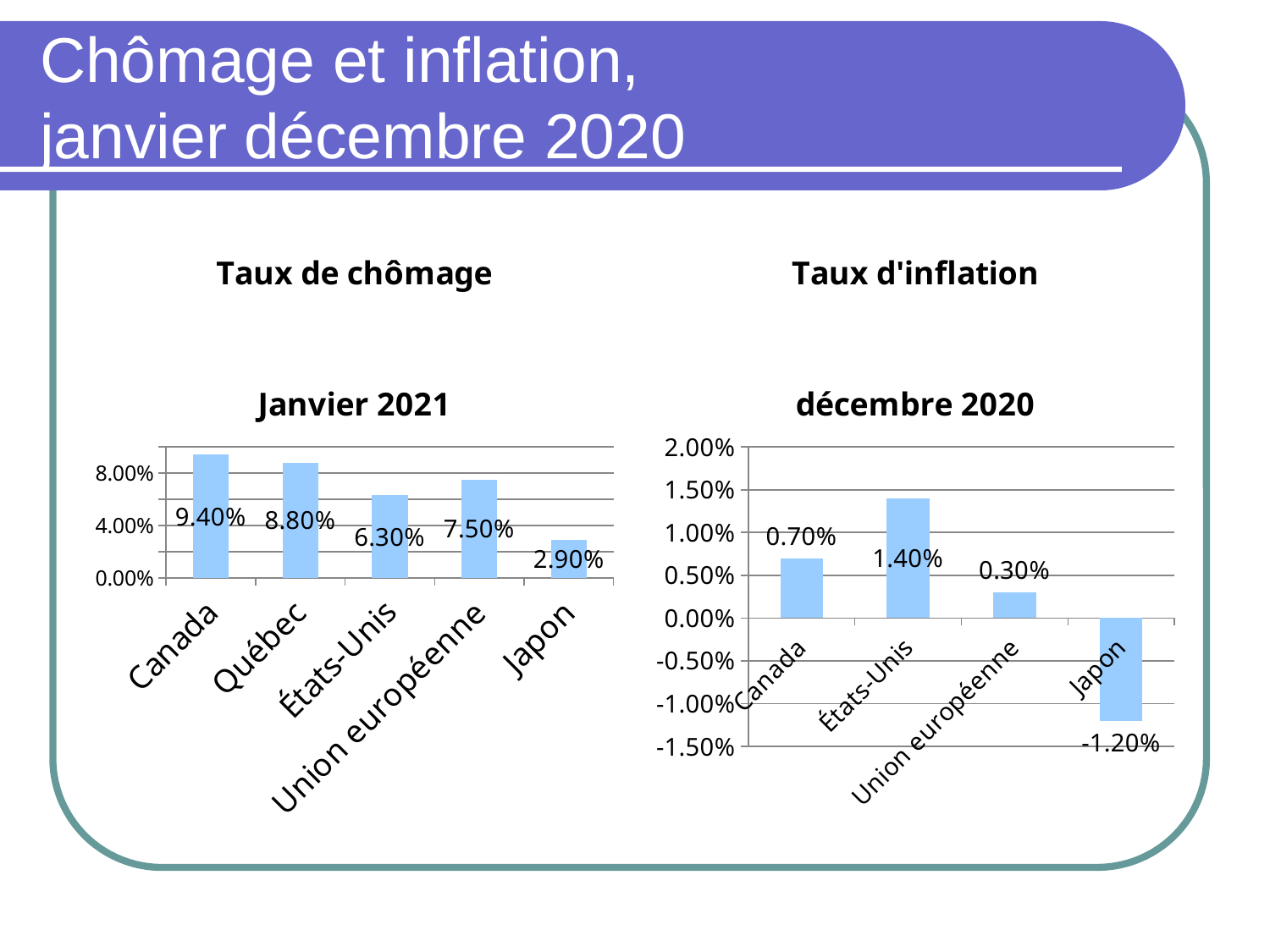
In the 'décembre 2020' chart (right), which category has the lowest value? Japon In the 'décembre 2020' chart (right), which is larger, the value for Canada or the value for Union européenne? Canada In the 'décembre 2020' chart (right), what is the value for Japon? -1.20% In the 'décembre 2020' chart (right), how many categories are shown? 4 In the 'décembre 2020' chart (right), what is the inflation rate for États-Unis? 1.40% What kind of chart is the 'Janvier 2021' chart on the left? Bar chart In the 'Janvier 2021' chart (left), what is the unemployment rate for Québec? 8.80% In the 'Janvier 2021' chart (left), which category has the highest value? Canada In the 'Janvier 2021' chart (left), what is the difference between the values for Canada and Japon? 6.50% In the 'Janvier 2021' chart (left), is the value for États-Unis greater or less than 8.00%? less In the 'Janvier 2021' chart (left), how many categories are shown? 5 In the 'Janvier 2021' chart (left), which category has the lowest value? Japon